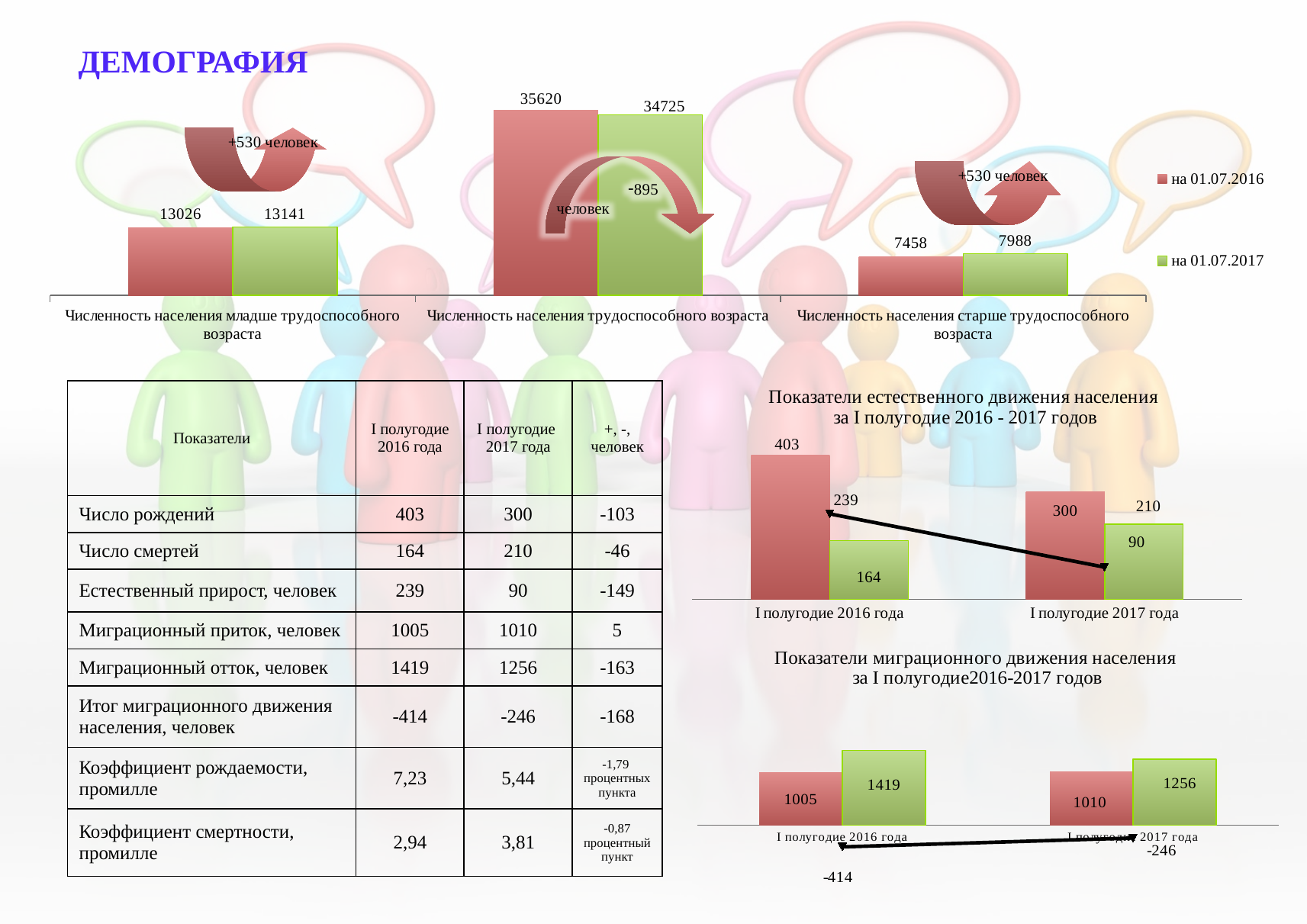
In the chart 'Показатели естественного движения населения за I полугодие 2016 - 2017 годов', does the line (natural increase) rise or fall from 2016 to 2017? fall In the top population chart, what is the difference between the 01.07.2016 and 01.07.2017 values for 'Численность населения младше трудоспособного возраста'? 115 In the top population chart, which category has the highest values? Численность населения трудоспособного возраста In the top population chart, what is the value for 'Численность населения старше трудоспособного возраста' on 01.07.2017? 7988 In the top population chart, which legend entry is shown in green? на 01.07.2017 In the chart 'Показатели миграционного движения населения за I полугодие2016-2017 годов', which is larger: the red bar for 2016 or the red bar for 2017? the red bar for 2017 (1010) In the chart 'Показатели естественного движения населения за I полугодие 2016 - 2017 годов', what is the value of the green bar for 'I полугодие 2017 года'? 210 In the top population chart, what is the value for 'Численность населения трудоспособного возраста' on 01.07.2016? 35620 In the chart 'Показатели миграционного движения населения за I полугодие2016-2017 годов', what is the value of the green bar for 'I полугодие 2016 года'? 1419 What type of chart is 'Показатели миграционного движения населения за I полугодие2016-2017 годов'? combination bar and line chart In the chart 'Показатели естественного движения населения за I полугодие 2016 - 2017 годов', what is the value of the red bar for 'I полугодие 2016 года'? 403 In the top population chart, how many series does the legend list? 2